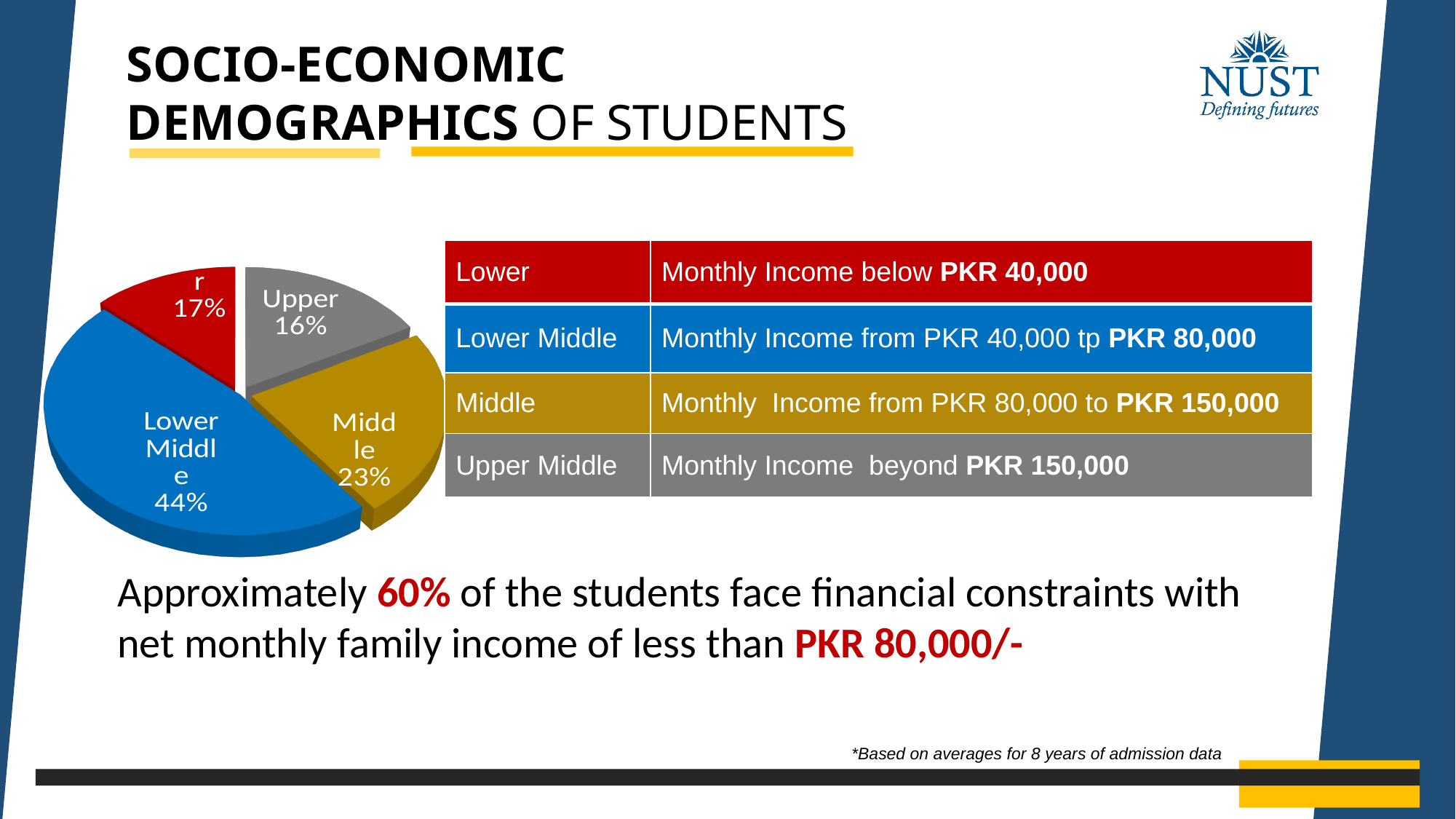
Which is larger in the pie chart, the Middle slice or the red slice? Middle What is the difference in percentage points between the Lower Middle slice and the Middle slice? 21 What kind of chart is shown on the slide? pie chart What colour is the Lower Middle slice in the pie chart? blue What percentage does the Middle slice of the pie chart show? 23% What percentage is shown on the grey slice labelled Upper in the pie chart? 16% Which slice of the pie chart is the smallest? Upper (16%) What percentage is shown on the red slice of the pie chart? 17% How many slices does the pie chart have? 4 What share of students are in the Lower Middle category in the pie chart? 44% According to the table, what monthly income range defines the Middle category? PKR 80,000 to PKR 150,000 Which category has the largest slice in the pie chart? Lower Middle